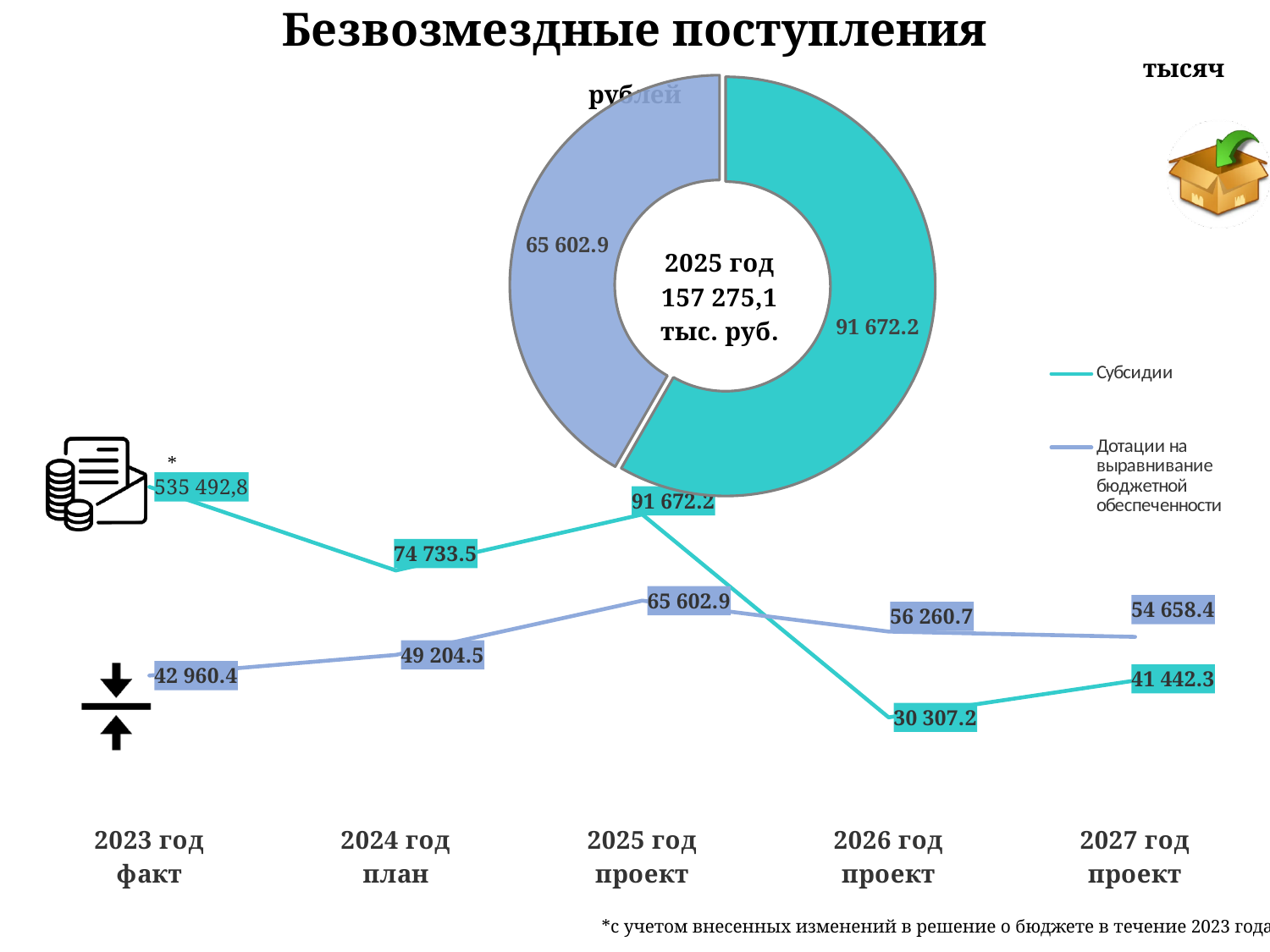
In the line chart, which year has the lowest value for Субсидии? 2026 год проект In the line chart, what is the difference between Дотации for 2025 год проект and 2024 год план? 16 398.4 In the line chart, how many series does the legend list? 2 In the line chart, what is the value of Субсидии for 2024 год план? 74 733.5 In the donut chart, what is the value of the Субсидии slice? 91 672.2 In the donut chart, what is the value of the Дотации на выравнивание бюджетной обеспеченности slice? 65 602.9 In the donut chart, which slice is larger, Субсидии or Дотации? Субсидии In the line chart, how many years are shown on the x axis? 5 In the donut chart, what total is shown in the centre for 2025 год? 157 275,1 тыс. руб. In the line chart, what is the value of Субсидии for 2026 год проект? 30 307.2 In the line chart, which year has the highest value for Дотации на выравнивание бюджетной обеспеченности? 2025 год проект In the line chart, what is the value of Дотации на выравнивание бюджетной обеспеченности for 2027 год проект? 54 658.4